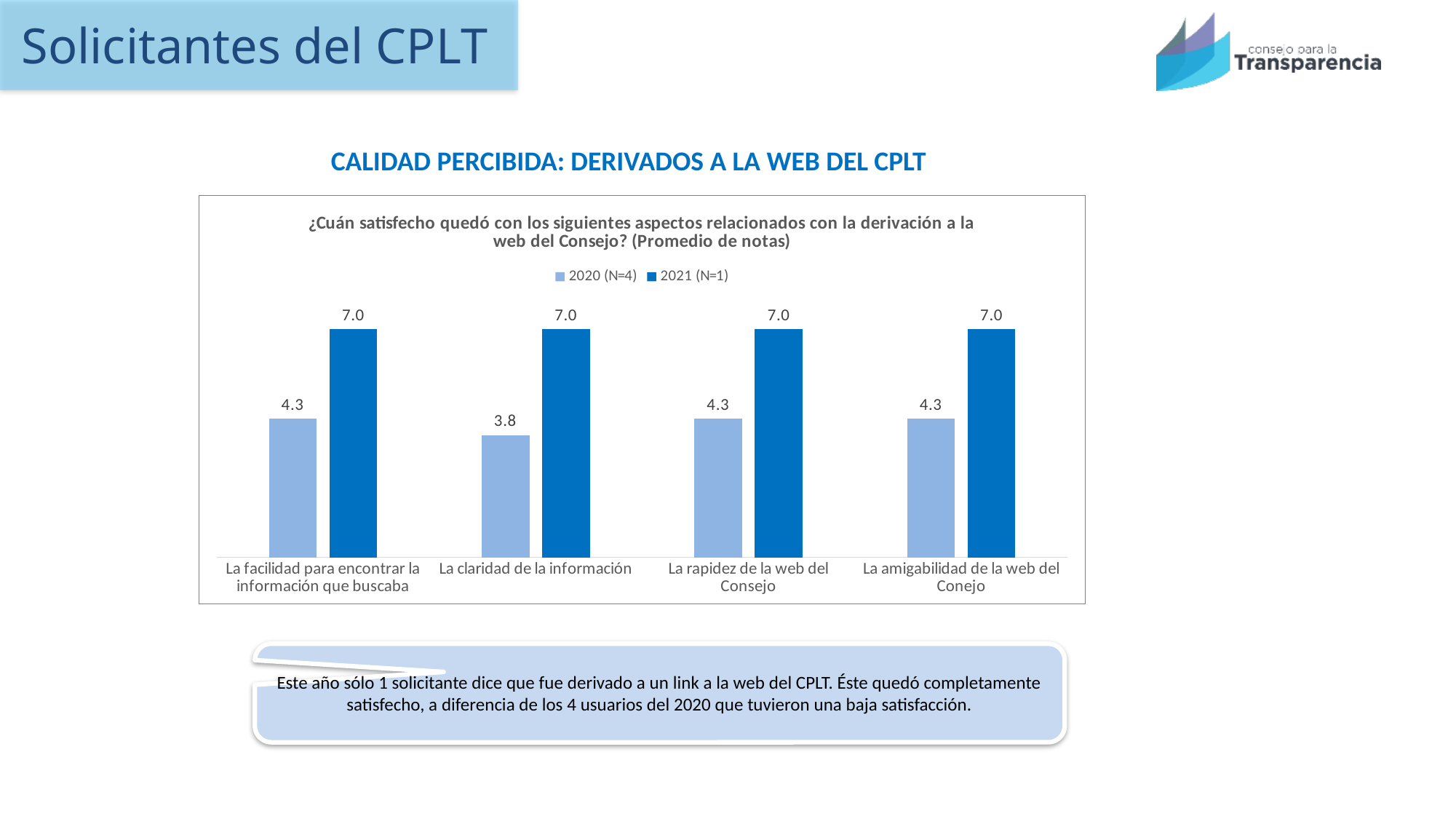
What is the 2020 (N=4) value for 'La facilidad para encontrar la información que buscaba'? 4.3 What is the difference between the 2021 (N=1) and 2020 (N=4) values for 'La amigabilidad de la web del Conejo'? 2.7 What kind of chart is shown on the slide? Bar chart Which is larger for 'La rapidez de la web del Consejo': the 2020 (N=4) value or the 2021 (N=1) value? 2021 (N=1) How many categories are shown on the x axis of the chart? 4 What is the 2020 (N=4) value for 'La claridad de la información'? 3.8 What is the 2021 (N=1) value for 'La facilidad para encontrar la información que buscaba'? 7.0 What are the two series named in the chart legend? 2020 (N=4) and 2021 (N=1) What is the 2021 (N=1) value for 'La rapidez de la web del Consejo'? 7.0 How many series does the legend list? 2 Which category has the lowest 2020 (N=4) value? La claridad de la información What is the difference between the 2021 (N=1) and 2020 (N=4) values for 'La claridad de la información'? 3.2